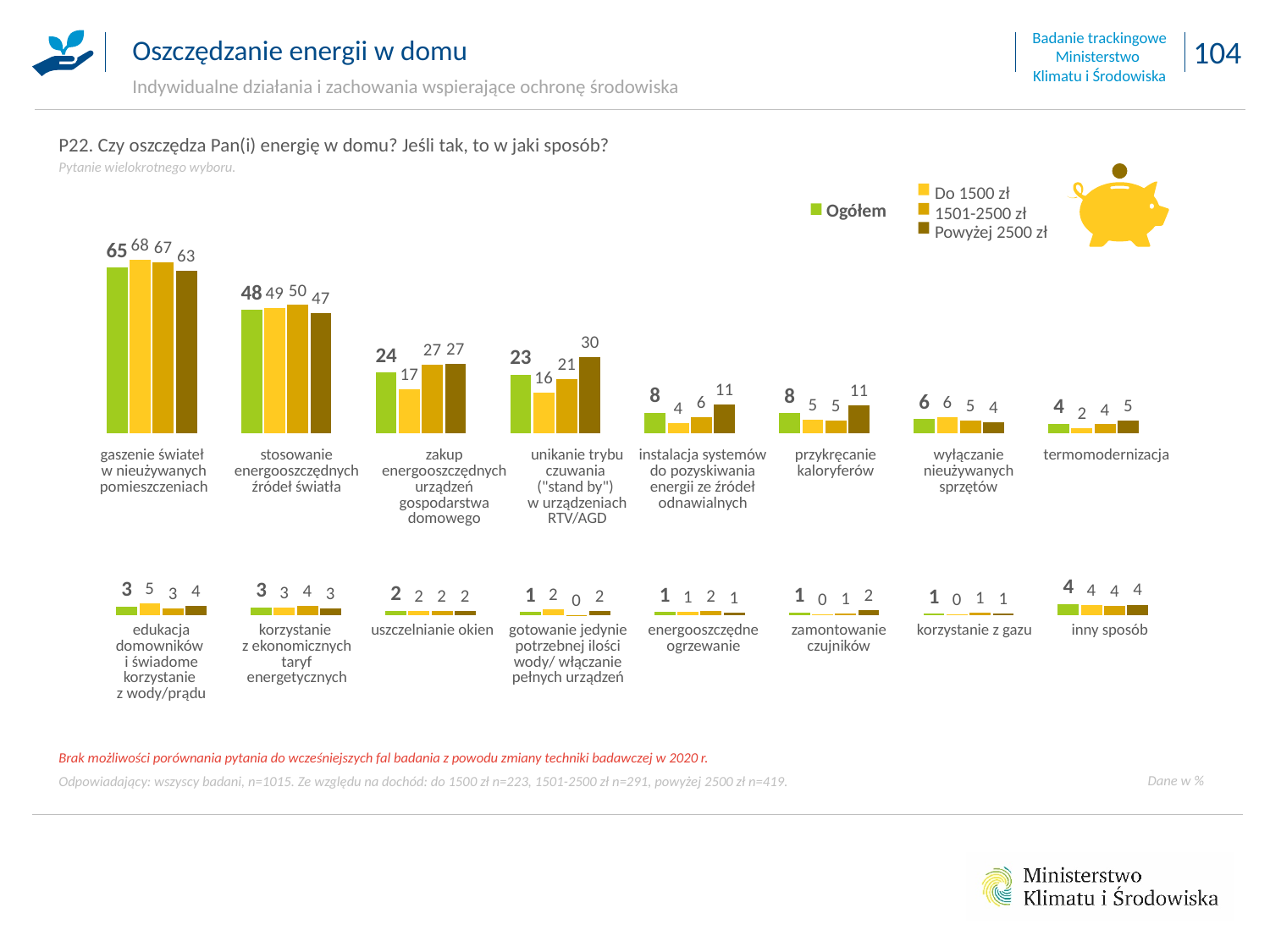
What is the difference between the "Do 1500 zł" and "Powyżej 2500 zł" values for "instalacja systemów do pozyskiwania energii ze źródeł odnawialnych"? 7 How many series does the legend list? 4 What is the difference between the Ogółem values for "gaszenie świateł w nieużywanych pomieszczeniach" and "stosowanie energooszczędnych źródeł światła"? 17 What is the Ogółem value for "termomodernizacja"? 4 Which category has the highest Ogółem value? gaszenie świateł w nieużywanych pomieszczeniach What kind of chart is shown on the slide? bar chart Which series in the legend is shown in green? Ogółem What is the "Do 1500 zł" value for "zakup energooszczędnych urządzeń gospodarstwa domowego"? 17 Which is larger for "przykręcanie kaloryferów": the "Do 1500 zł" value or the "Powyżej 2500 zł" value? Powyżej 2500 zł What is the value for "Powyżej 2500 zł" in the category "unikanie trybu czuwania ("stand by") w urządzeniach RTV/AGD"? 30 What is the Ogółem value for "gaszenie świateł w nieużywanych pomieszczeniach"? 65 What is the "1501-2500 zł" value for "gotowanie jedynie potrzebnej ilości wody/ włączanie pełnych urządzeń"? 0